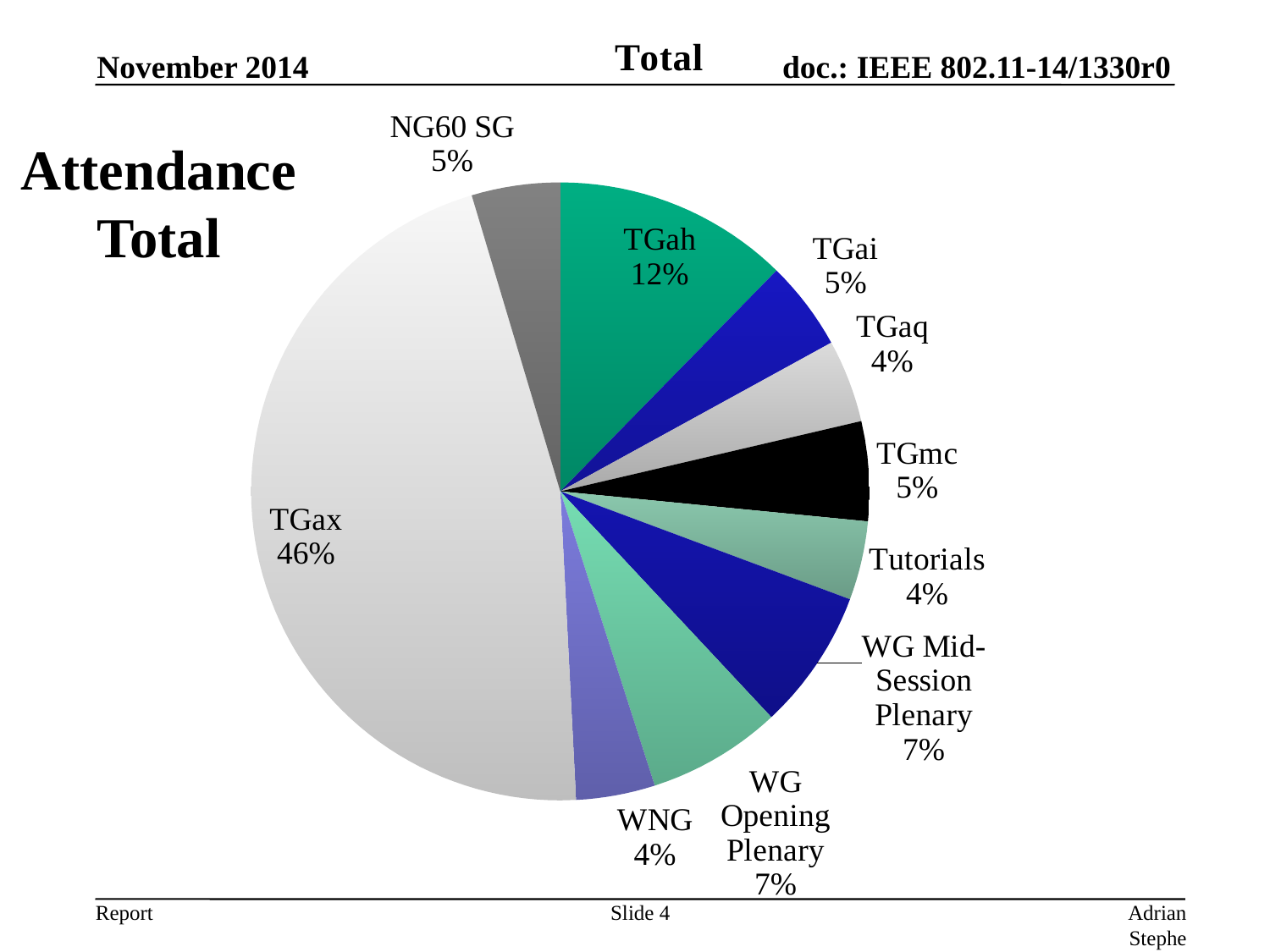
How many slices does the pie chart have? 10 What is the difference between the WG Opening Plenary share and the WNG share? 3% What is the difference between the TGax share and the TGah share? 34% What share of the pie does TGah have? 12% Which is larger, the share for TGah or the share for TGmc? TGah What kind of chart is shown on the slide? pie chart Which slice of the pie is the largest? TGax What is the value shown for Tutorials? 4% What share of the pie does TGax have? 46% What is the value shown for NG60 SG? 5% What is the value shown for WG Mid-Session Plenary? 7% What is the title of the pie chart? Total